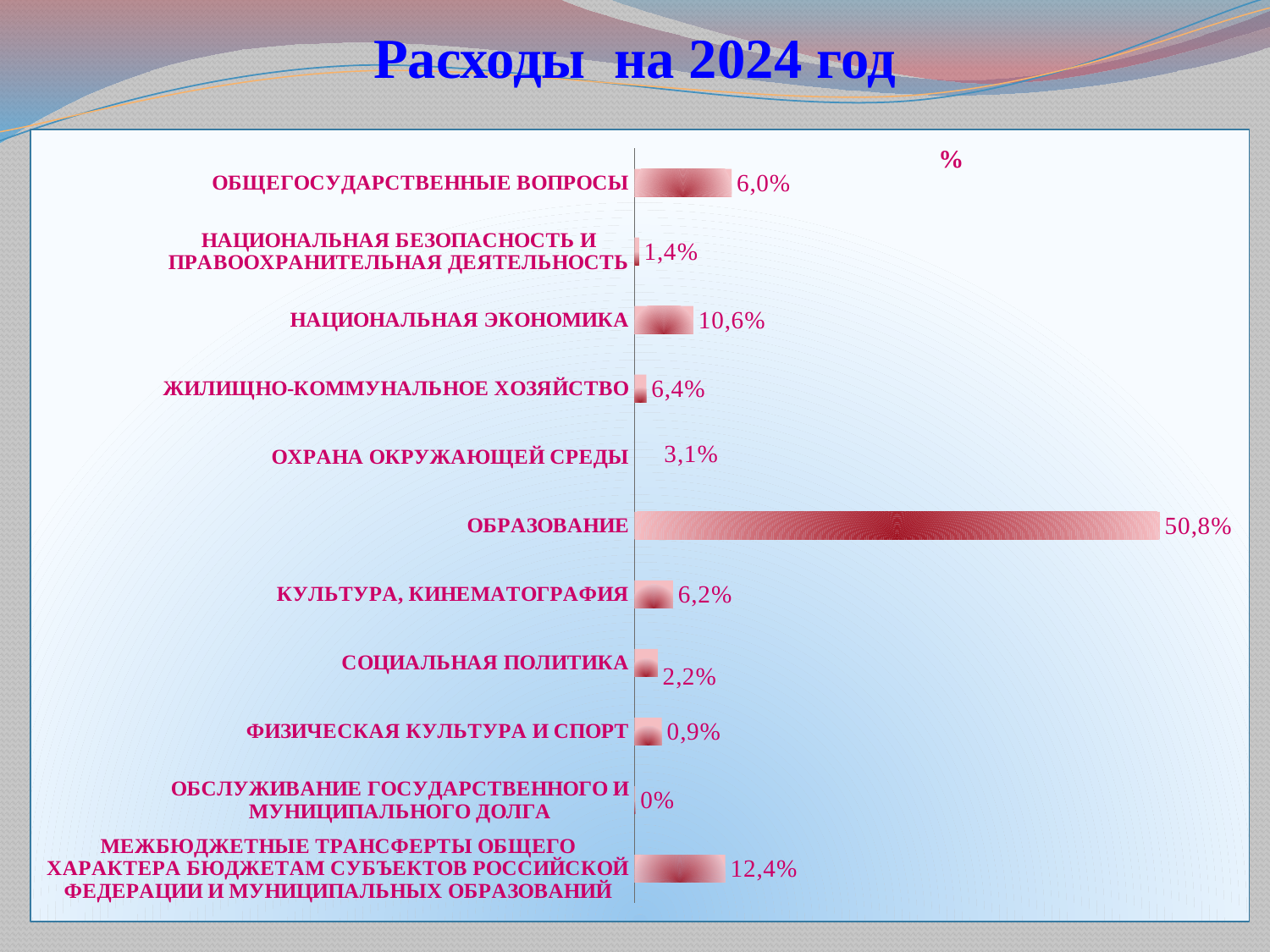
What is the value for МЕЖБЮДЖЕТНЫЕ ТРАНСФЕРТЫ ОБЩЕГО ХАРАКТЕРА БЮДЖЕТАМ СУБЪЕКТОВ РОССИЙСКОЙ ФЕДЕРАЦИИ И МУНИЦИПАЛЬНЫХ ОБРАЗОВАНИЙ? 12,4% How many categories are shown in the chart? 11 What is the value for ОХРАНА ОКРУЖАЮЩЕЙ СРЕДЫ? 3,1% Which is larger: the value for НАЦИОНАЛЬНАЯ ЭКОНОМИКА or the value for МЕЖБЮДЖЕТНЫЕ ТРАНСФЕРТЫ ОБЩЕГО ХАРАКТЕРА БЮДЖЕТАМ СУБЪЕКТОВ РОССИЙСКОЙ ФЕДЕРАЦИИ И МУНИЦИПАЛЬНЫХ ОБРАЗОВАНИЙ? МЕЖБЮДЖЕТНЫЕ ТРАНСФЕРТЫ ОБЩЕГО ХАРАКТЕРА БЮДЖЕТАМ СУБЪЕКТОВ РОССИЙСКОЙ ФЕДЕРАЦИИ И МУНИЦИПАЛЬНЫХ ОБРАЗОВАНИЙ Which category has the lowest value? ОБСЛУЖИВАНИЕ ГОСУДАРСТВЕННОГО И МУНИЦИПАЛЬНОГО ДОЛГА What is the value for ОБРАЗОВАНИЕ? 50,8% Which category has the highest value? ОБРАЗОВАНИЕ What is the title of the chart on the slide? % What kind of chart is shown on the slide? bar chart What is the difference between the values for ОБРАЗОВАНИЕ and НАЦИОНАЛЬНАЯ ЭКОНОМИКА? 40,2% What is the value for НАЦИОНАЛЬНАЯ ЭКОНОМИКА? 10,6% What is the value for ФИЗИЧЕСКАЯ КУЛЬТУРА И СПОРТ? 0,9%